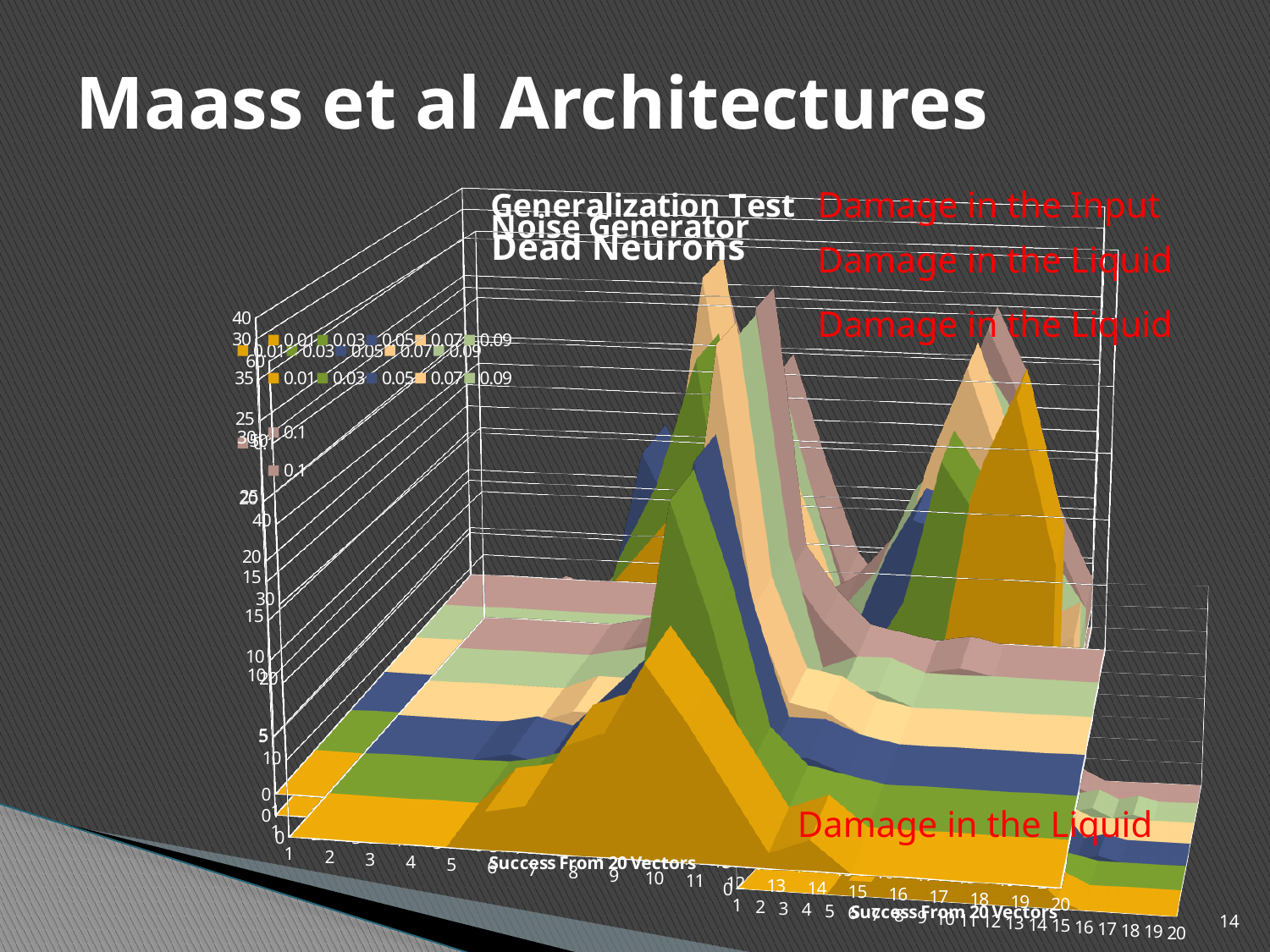
What is the first category on the x axis of the chart? 1 What are the series names listed in the chart legend? 0.01, 0.03, 0.05, 0.07, 0.09, 0.1 What kind of chart is shown on the slide? 3D area chart What is the last category on the x axis of the chart? 20 What is the label of the x axis of the chart? Success From 20 Vectors How many series does the legend of the chart list? 6 How many categories are shown along the x axis of the chart? 20